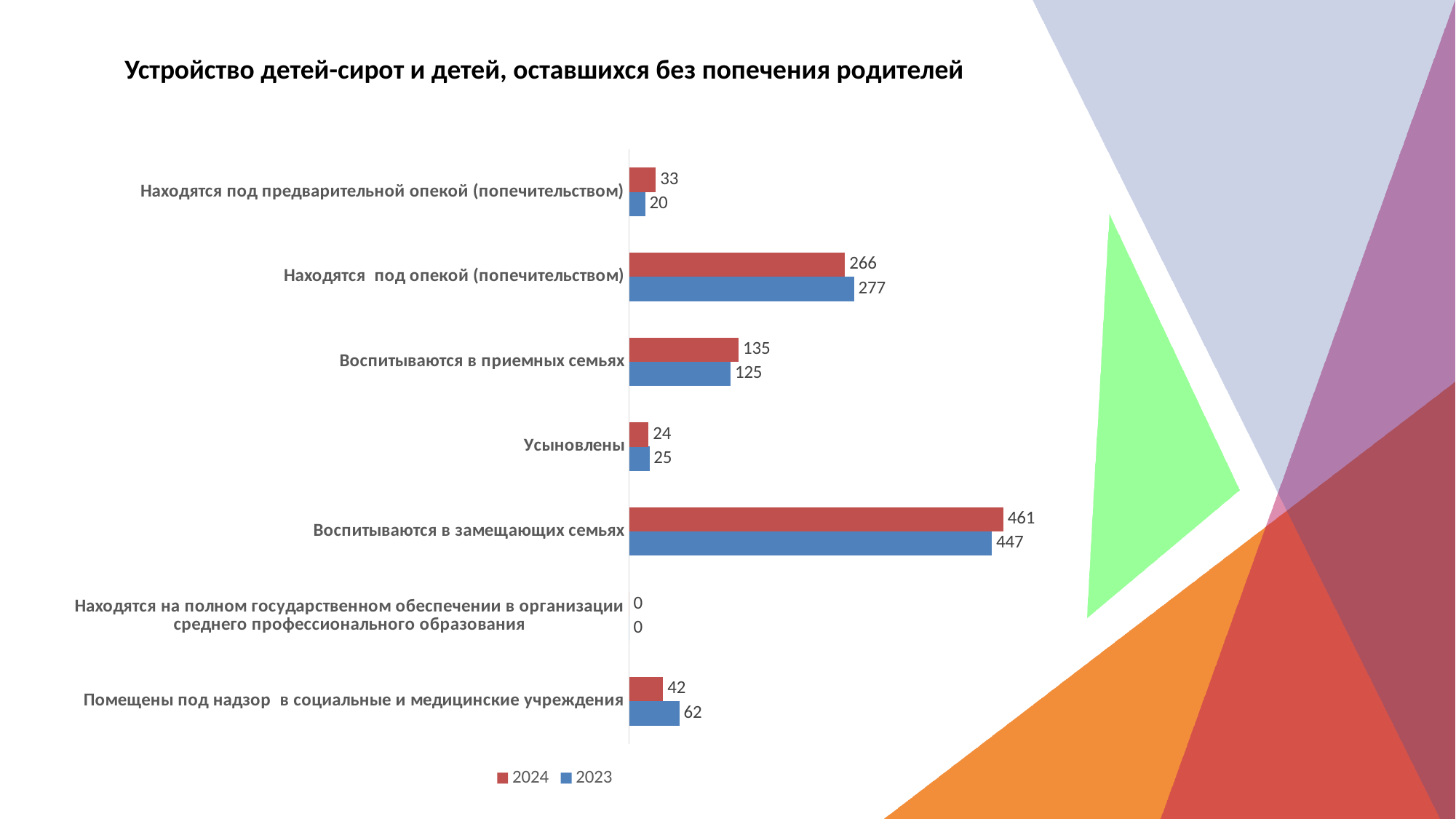
Which is larger for "Находятся под опекой (попечительством)": the 2024 value or the 2023 value? 2023 What is the 2024 value for "Находятся под предварительной опекой (попечительством)"? 33 Which category has the highest 2024 value? Воспитываются в замещающих семьях What is the difference between the 2024 and 2023 values for "Воспитываются в приемных семьях"? 10 What is the 2024 value for "Воспитываются в замещающих семьях"? 461 What is the 2023 value for "Находятся под опекой (попечительством)"? 277 What is the difference between the 2023 and 2024 values for "Помещены под надзор в социальные и медицинские учреждения"? 20 What is the 2023 value for "Помещены под надзор в социальные и медицинские учреждения"? 62 How many categories are shown on the chart? 7 Which category has the lowest 2023 value? Находятся на полном государственном обеспечении в организации среднего профессионального образования How many series does the legend list? 2 What kind of chart is shown on the slide? Bar chart